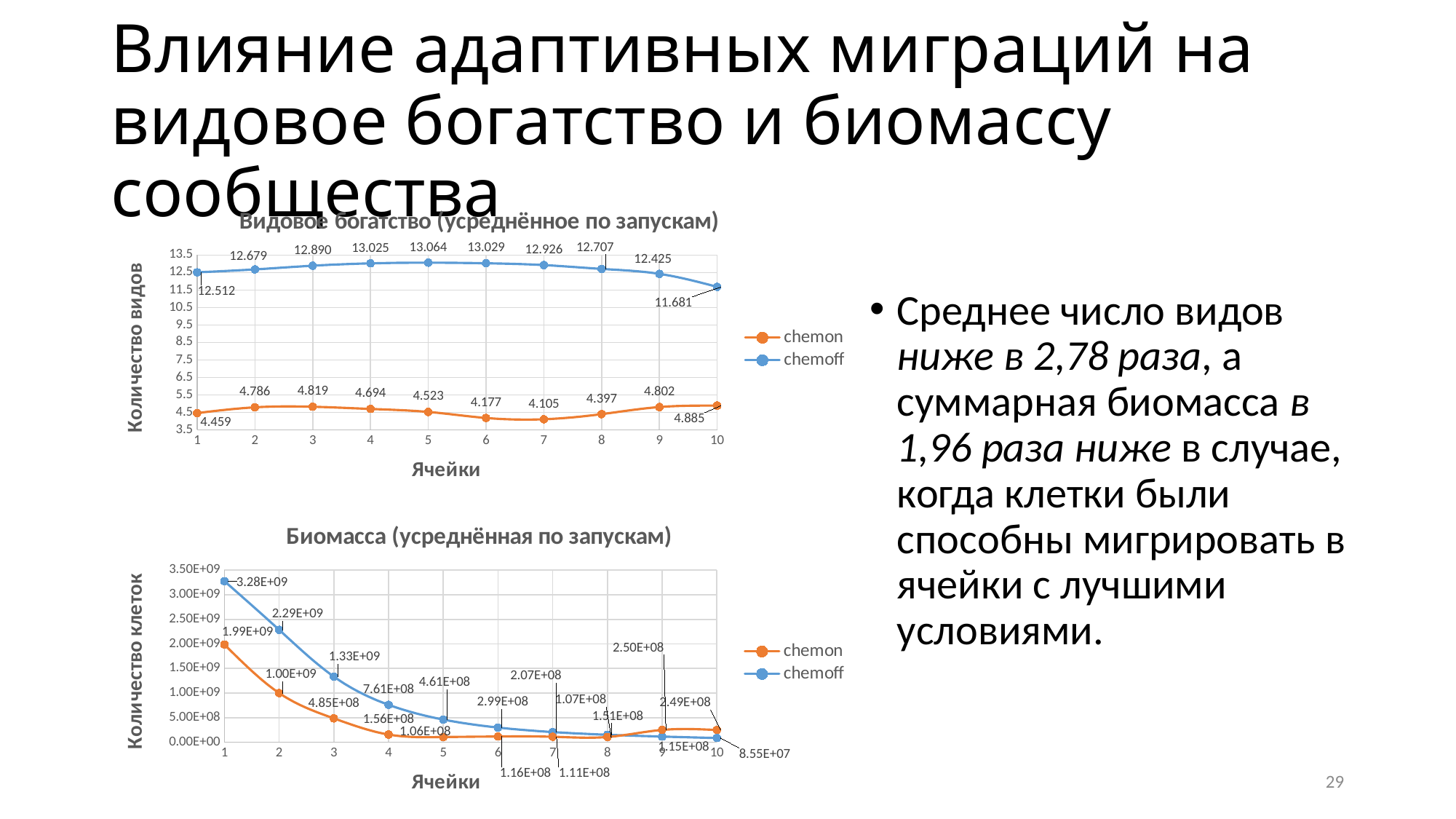
In the chart titled "Биомасса (усреднённая по запускам)", what is the value of the chemoff series at cell 1? 3.28E+09 In the chart titled "Видовое богатство (усреднённое по запускам)", what is the difference between the chemoff and chemon values at cell 1? 8.053 In the chart titled "Видовое богатство (усреднённое по запускам)", how many cells are shown on the x axis? 10 In the chart titled "Видовое богатство (усреднённое по запускам)", at which cell does the chemon series reach its highest value? 10 What kind of chart is the chart titled "Видовое богатство (усреднённое по запускам)"? line chart In the chart titled "Видовое богатство (усреднённое по запускам)", what is the value of the chemoff series at cell 5? 13.064 In the chart titled "Видовое богатство (усреднённое по запускам)", what is the value of the chemon series at cell 1? 4.459 In the chart titled "Видовое богатство (усреднённое по запускам)", at which cell does the chemoff series reach its lowest value? 10 In the chart titled "Биомасса (усреднённая по запускам)", which series has the larger value at cell 3, chemon or chemoff? chemoff How many series does the legend of the chart titled "Биомасса (усреднённая по запускам)" list? 2 In the chart titled "Биомасса (усреднённая по запускам)", what is the value of the chemon series at cell 2? 1.00E+09 In the chart titled "Биомасса (усреднённая по запускам)", does the chemoff series rise or fall from cell 1 to cell 10? fall